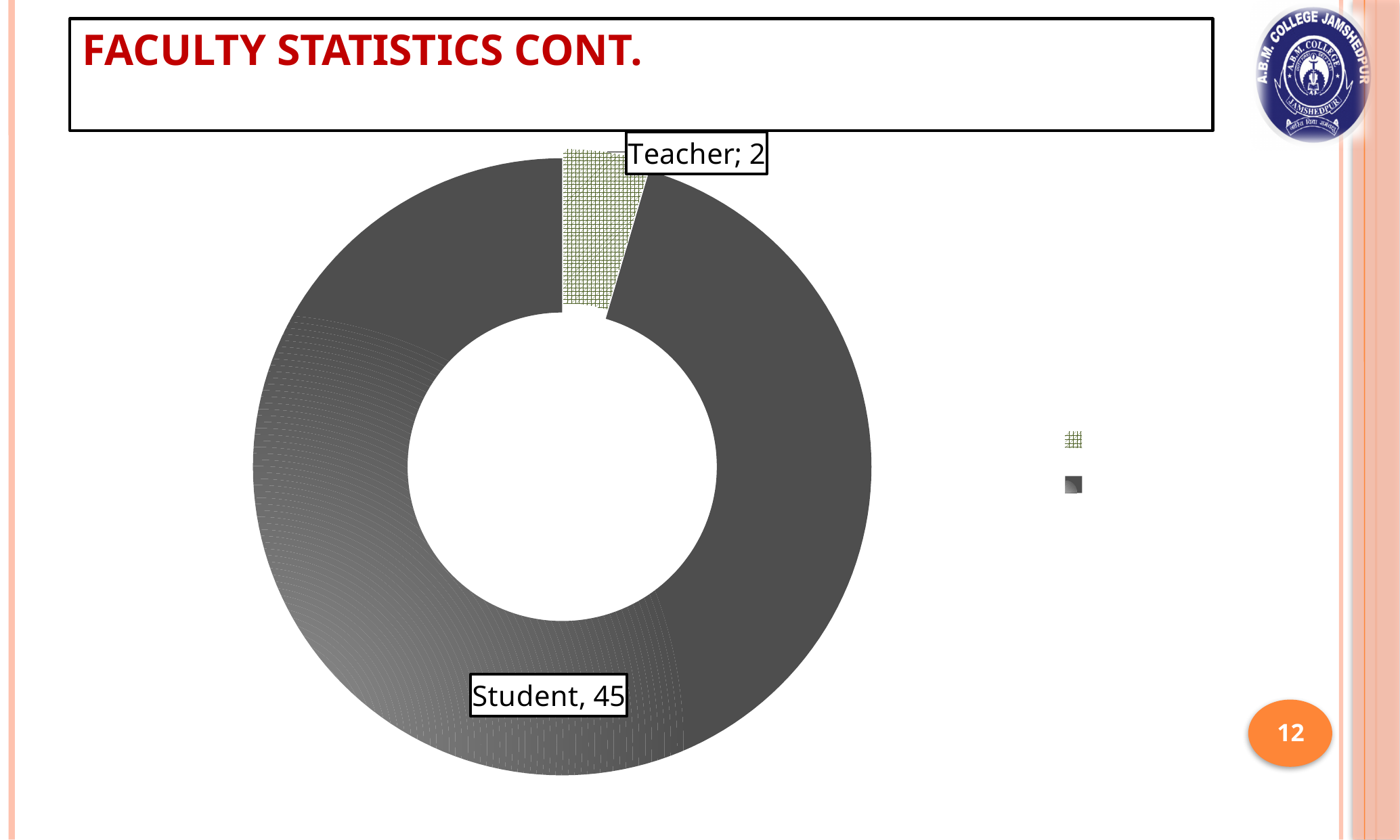
What is the total of the values shown in the chart? 47 Which category has the smallest slice in the chart? Teacher What is the value for Student in the chart? 45 What kind of chart is shown on the slide? doughnut chart What is the difference between the Student value and the Teacher value? 43 Which slice of the chart has a green cross-hatched pattern fill? Teacher What is the value for Teacher in the chart? 2 How many entries does the chart legend list? 2 Which is larger, the value for Student or the value for Teacher? Student What is the title of the slide containing the chart? FACULTY STATISTICS CONT. How many categories are shown in the chart? 2 Which category has the largest slice in the chart? Student